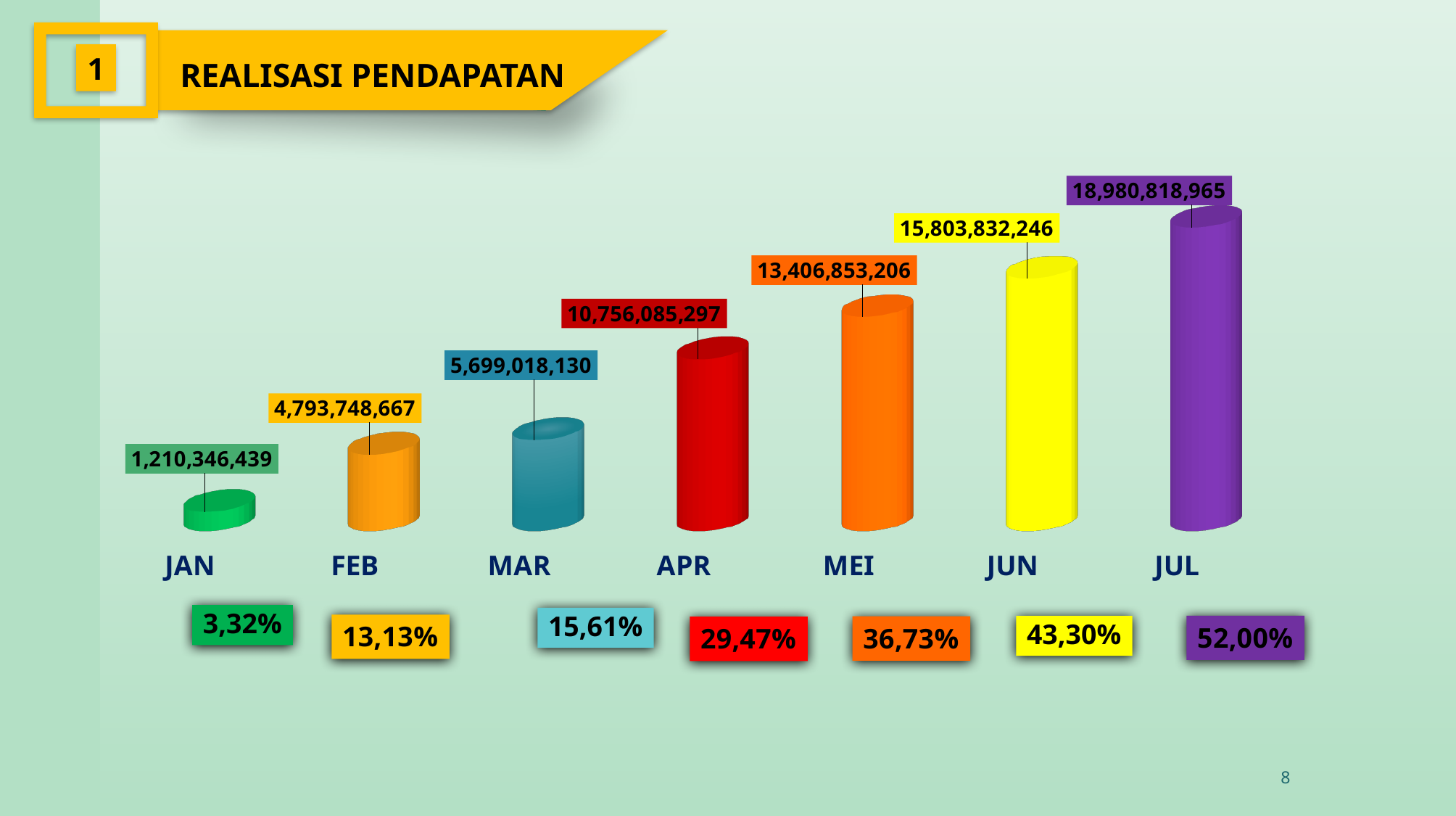
What is the difference between the values for JUL and JAN? 17,770,472,526 What is the value for APR? 10,756,085,297 Which month has the lowest value? JAN What is the difference between the values for MAR and FEB? 905,269,463 Do the values rise or fall from JAN to JUL? rise What is the value for JAN? 1,210,346,439 What is the value for JUN? 15,803,832,246 What kind of chart is shown on the slide? bar chart Which month has the highest value? JUL What is the title of the chart? REALISASI PENDAPATAN Which is larger, the value for MEI or the value for APR? MEI How many months are shown on the chart? 7